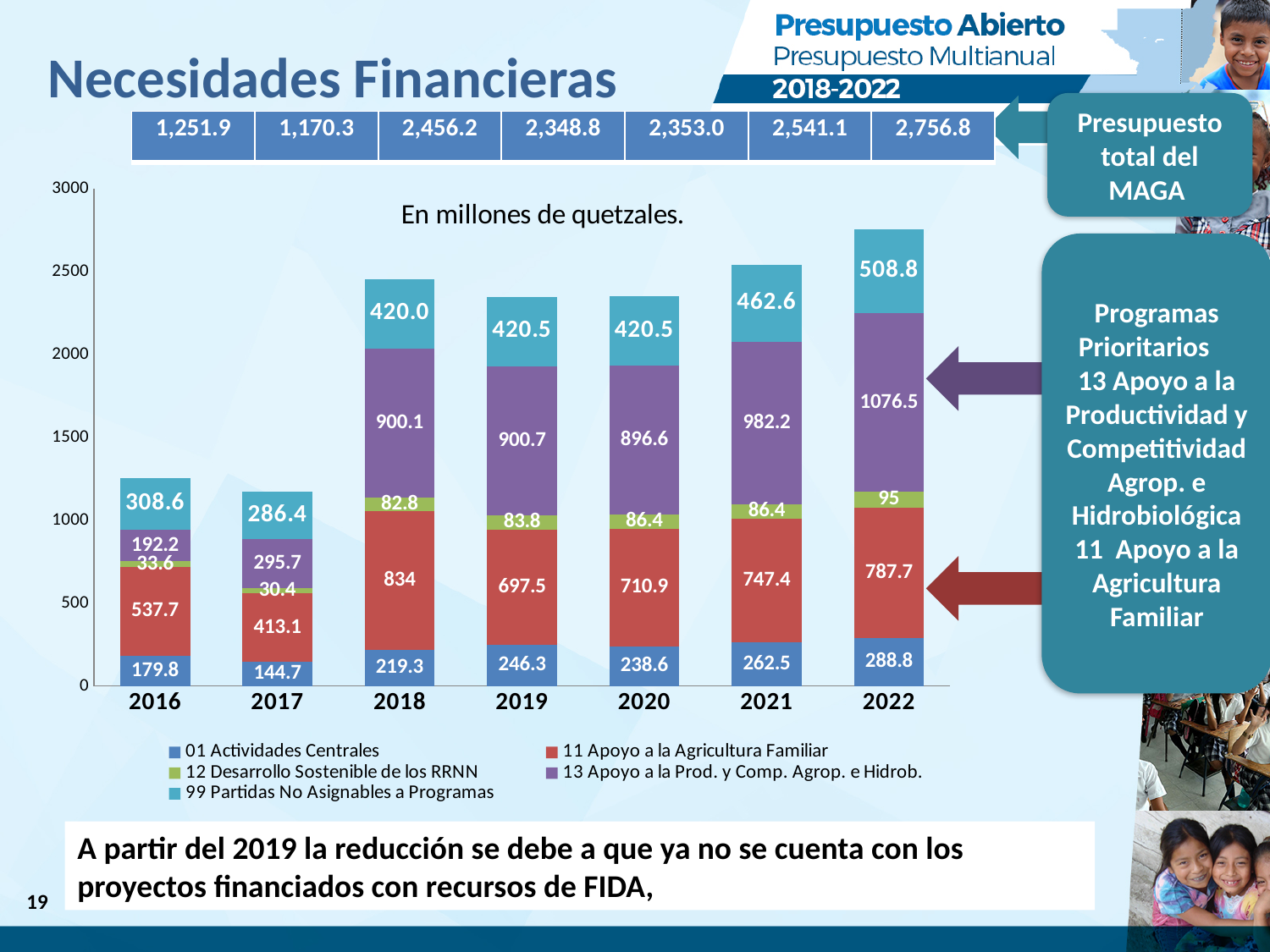
In which year is the value for 01 Actividades Centrales lowest? 2017 What is the total of the stacked bar for 2022? 2,756.8 What is the value for 01 Actividades Centrales in 2019? 246.3 In which year is the value for 13 Apoyo a la Prod. y Comp. Agrop. e Hidrob. highest? 2022 What is the value for 11 Apoyo a la Agricultura Familiar in 2018? 834 What is the value for 99 Partidas No Asignables a Programas in 2016? 308.6 How many years are shown on the x axis of the chart? 7 Which year has the larger value for 13 Apoyo a la Prod. y Comp. Agrop. e Hidrob., 2020 or 2021? 2021 What is the value for 13 Apoyo a la Prod. y Comp. Agrop. e Hidrob. in 2022? 1076.5 What kind of chart is shown on the slide? Stacked bar chart What is the difference between the 2022 and 2021 values for 99 Partidas No Asignables a Programas? 46.2 How many series does the chart legend list? 5